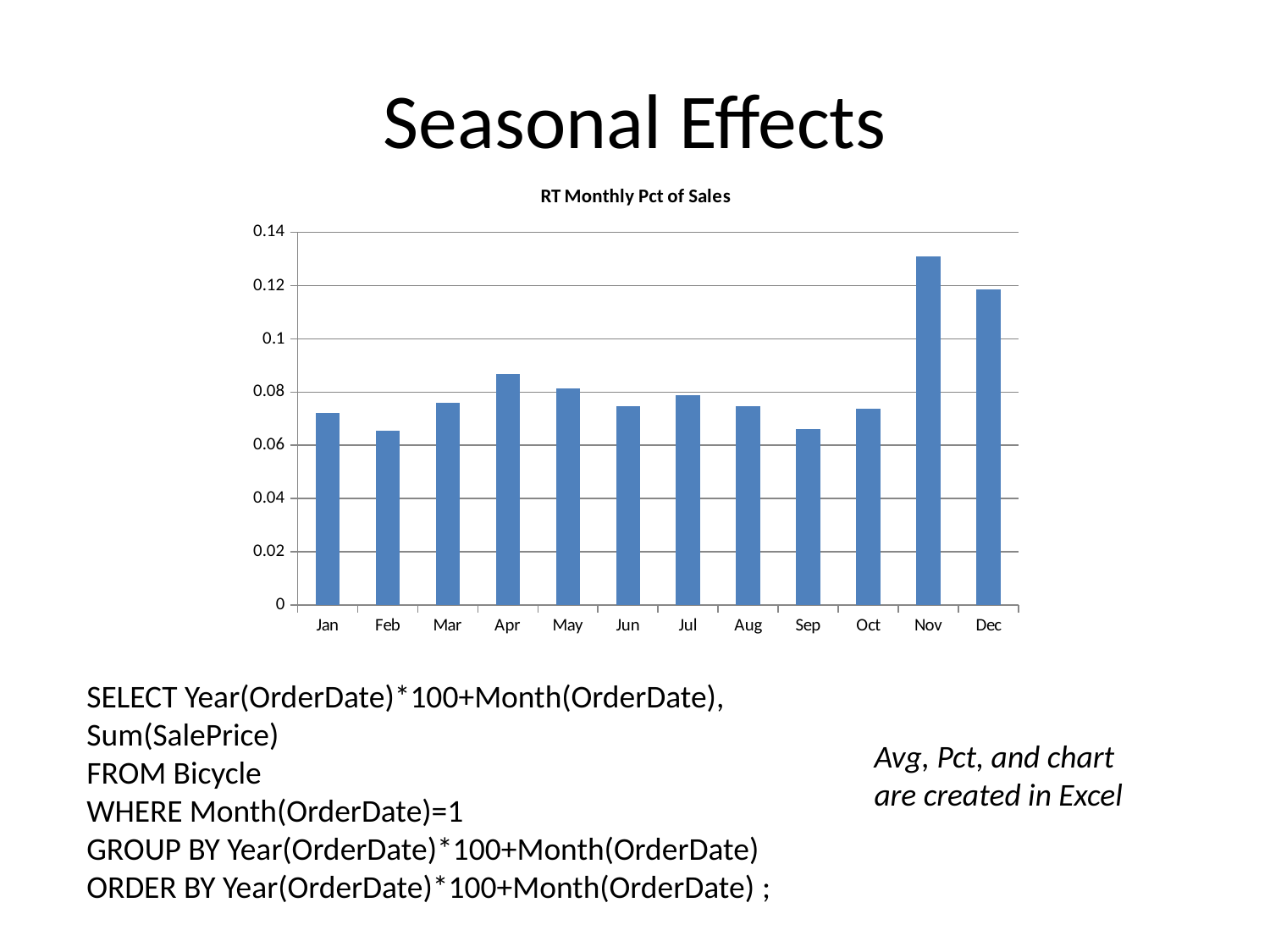
Is the value for Nov greater or less than 0.12? greater How many months are plotted on the x axis of the chart? 12 Which month has the highest value in the chart? Nov What is the title of the chart? RT Monthly Pct of Sales Does the value rise or fall from Oct to Nov? rise What kind of chart is shown on the slide? bar chart Is the value for Feb greater or less than 0.08? less Is the value for Sep greater or less than 0.08? less Which is larger, the value for Nov or the value for Dec? Nov Which is larger, the value for Apr or the value for May? Apr